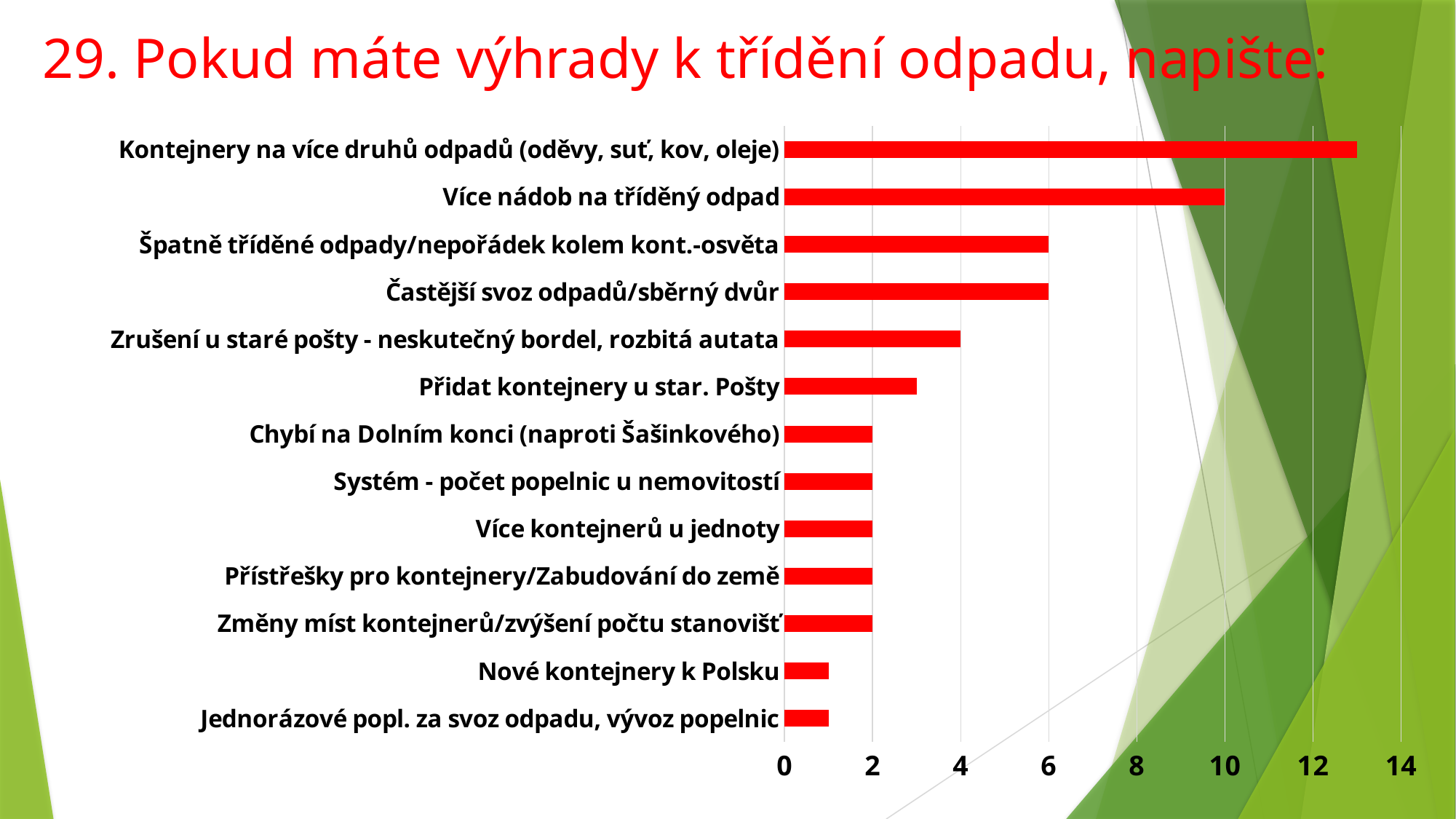
What is the difference between the values for "Více nádob na tříděný odpad" and "Špatně tříděné odpady/nepořádek kolem kont.-osvěta"? 4 What is the value for "Zrušení u staré pošty - neskutečný bordel, rozbitá autata"? 4 Which is larger: the value for "Více nádob na tříděný odpad" or the value for "Špatně tříděné odpady/nepořádek kolem kont.-osvěta"? Více nádob na tříděný odpad What kind of chart is shown on the slide? bar chart What is the value for "Více nádob na tříděný odpad"? 10 How many categories are plotted in the chart? 13 What colour are the bars in the chart? red What is the value for "Častější svoz odpadů/sběrný dvůr"? 6 Is the value for "Nové kontejnery k Polsku" greater or less than 2? less Which category has the highest value? Kontejnery na více druhů odpadů (oděvy, suť, kov, oleje) Is the value for "Kontejnery na více druhů odpadů (oděvy, suť, kov, oleje)" greater or less than 12? greater What is the value for "Více kontejnerů u jednoty"? 2